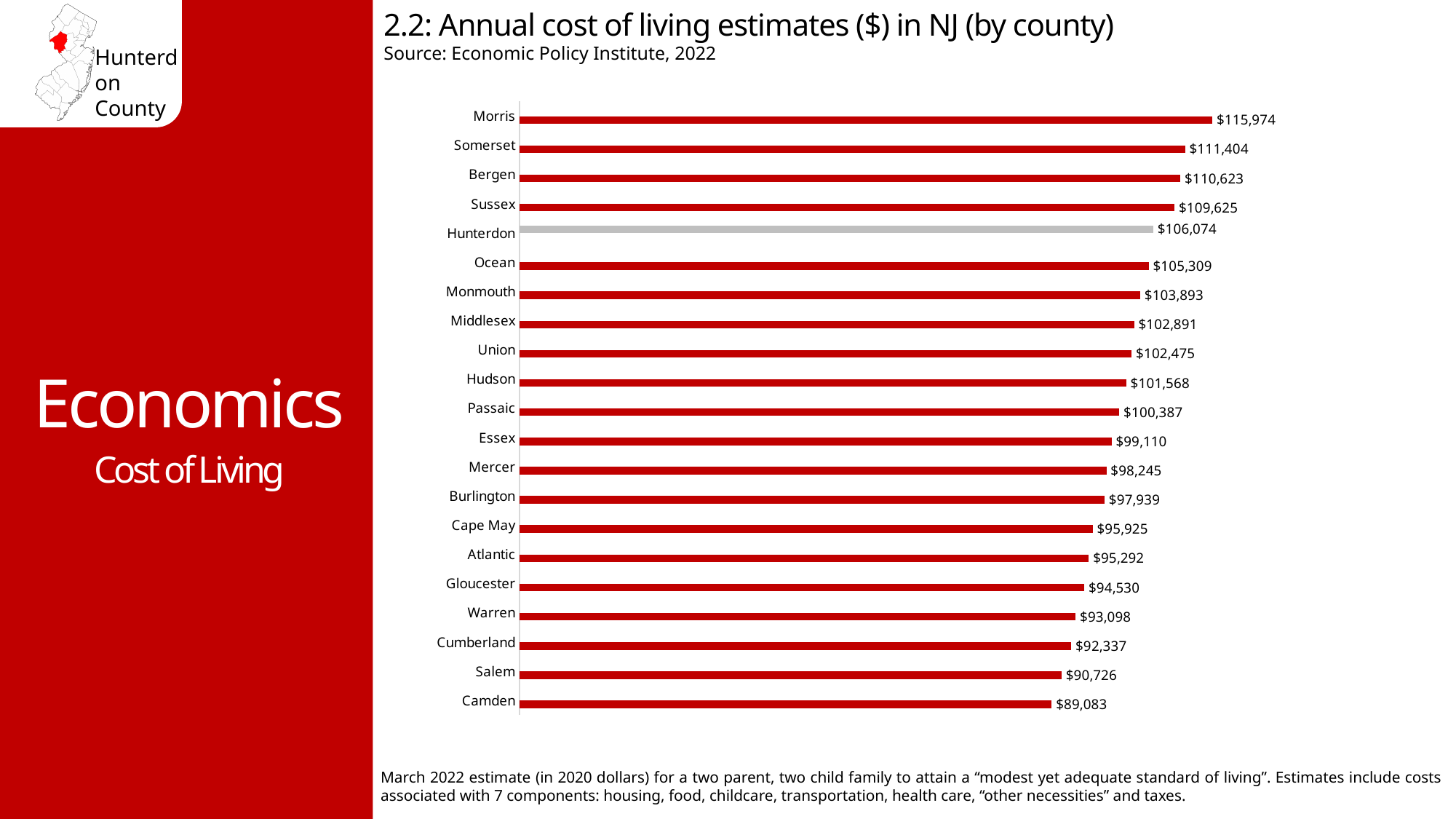
What is the annual cost of living estimate for Warren County? $93,098 What is the annual cost of living estimate for Middlesex County? $102,891 Which county has a higher cost of living estimate, Ocean or Monmouth? Ocean Which county has a higher cost of living estimate, Salem or Cumberland? Cumberland What type of chart is used to show the annual cost of living estimates? Bar chart What is the difference between the cost of living estimates for Morris and Camden counties? $26,891 Which county's bar is shown in grey rather than red? Hunterdon What is the annual cost of living estimate for Hunterdon County? $106,074 Which county has the lowest annual cost of living estimate? Camden What is the difference between the cost of living estimates for Hunterdon and Warren counties? $12,976 Which county has the highest annual cost of living estimate? Morris How many counties are shown in the chart? 21